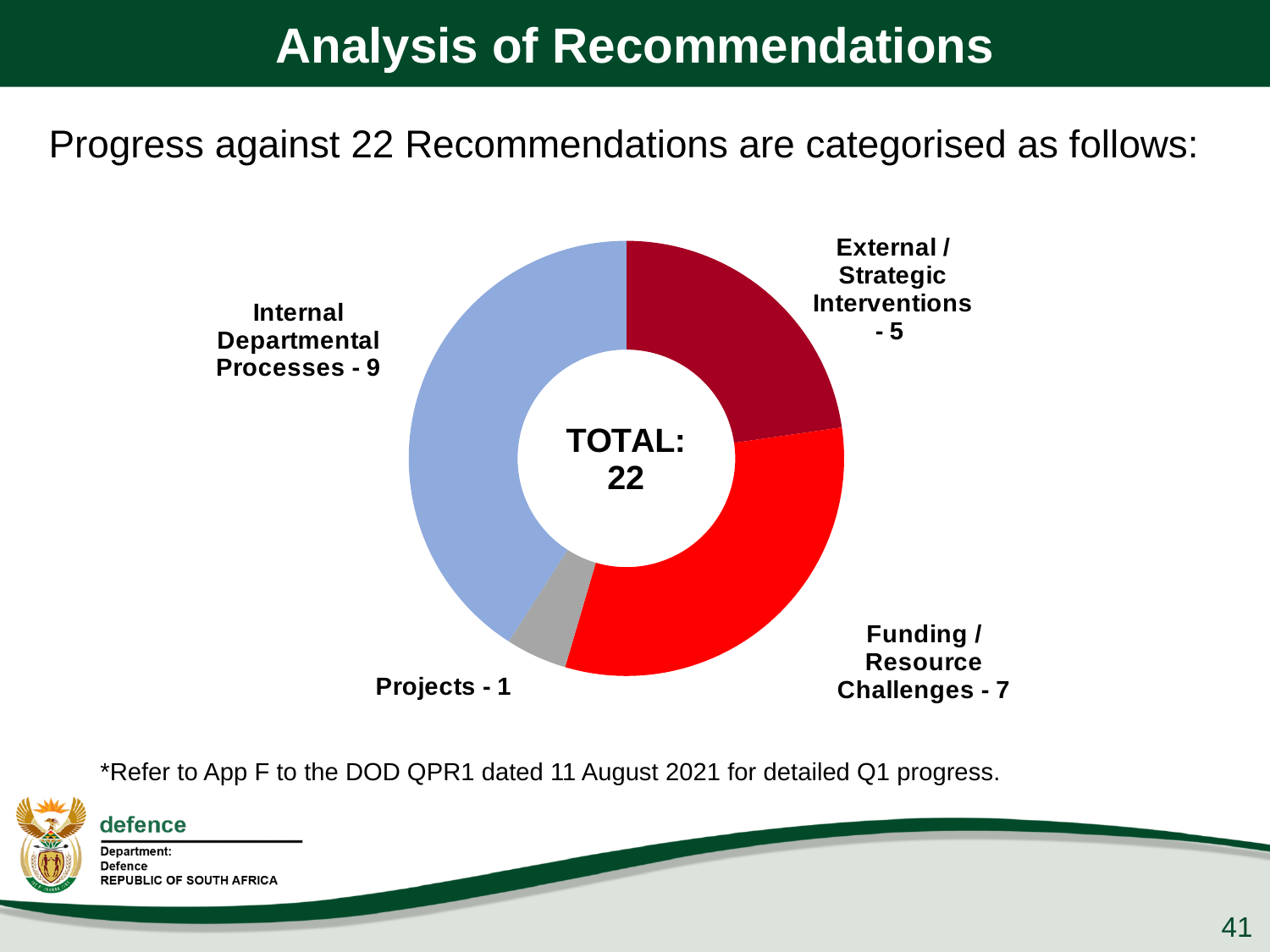
How many recommendations fall under Projects? 1 How many recommendations fall under Internal Departmental Processes? 9 What colour is the Projects slice of the chart? Grey How many recommendations fall under External / Strategic Interventions? 5 Which category has the highest number of recommendations? Internal Departmental Processes Which has more recommendations: External / Strategic Interventions or Funding / Resource Challenges? Funding / Resource Challenges Which category has the lowest number of recommendations? Projects How many categories are shown in the chart? 4 What kind of chart is shown on the slide? Doughnut (pie) chart How many recommendations fall under Funding / Resource Challenges? 7 What is the difference between the number of recommendations for Internal Departmental Processes and Funding / Resource Challenges? 2 What is the total number of recommendations shown in the centre of the chart? 22